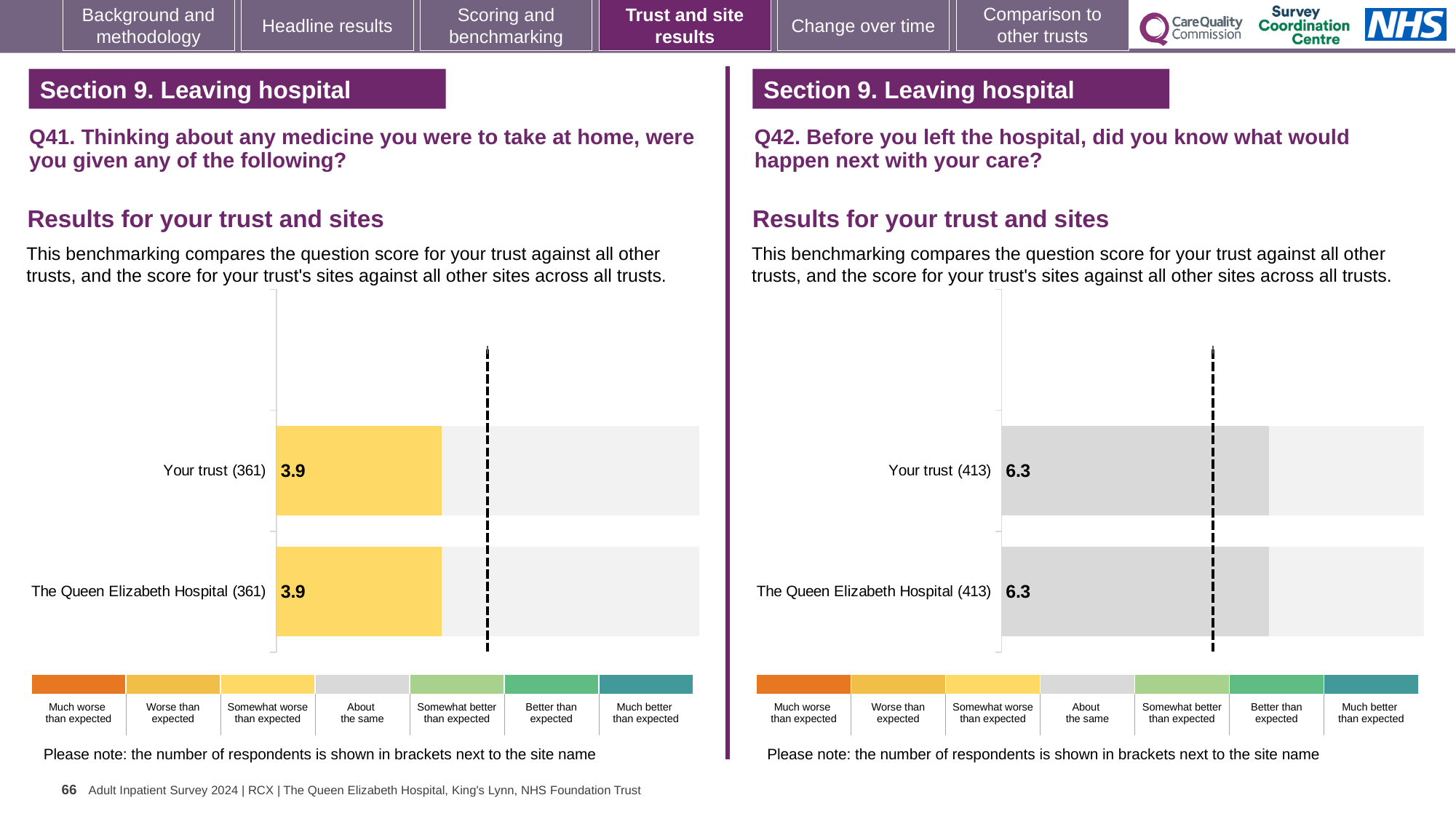
On the Q41 chart (left), how many respondents are shown in brackets next to Your trust? 361 Is the score for Your trust on the Q42 chart (right) larger or smaller than the score for Your trust on the Q41 chart (left)? Larger On the Q41 chart (left), what is the score for The Queen Elizabeth Hospital? 3.9 On the Q41 chart (left), what is the score for Your trust? 3.9 On the Q41 chart (left), which benchmark category does the colour of the bars correspond to according to the key? Somewhat worse than expected On the Q42 chart (right), how many respondents are shown in brackets next to The Queen Elizabeth Hospital? 413 On the Q41 chart (left), what is the difference between the score for Your trust and the score for The Queen Elizabeth Hospital? 0 On the Q42 chart (right), what is the score for The Queen Elizabeth Hospital? 6.3 On the Q42 chart (right), what is the score for Your trust? 6.3 On the Q42 chart (right), which benchmark category does the colour of the bars correspond to according to the key? About the same On the Q42 chart (right), how many bars are plotted? 2 What kind of chart is shown on the left for Q41? Bar chart